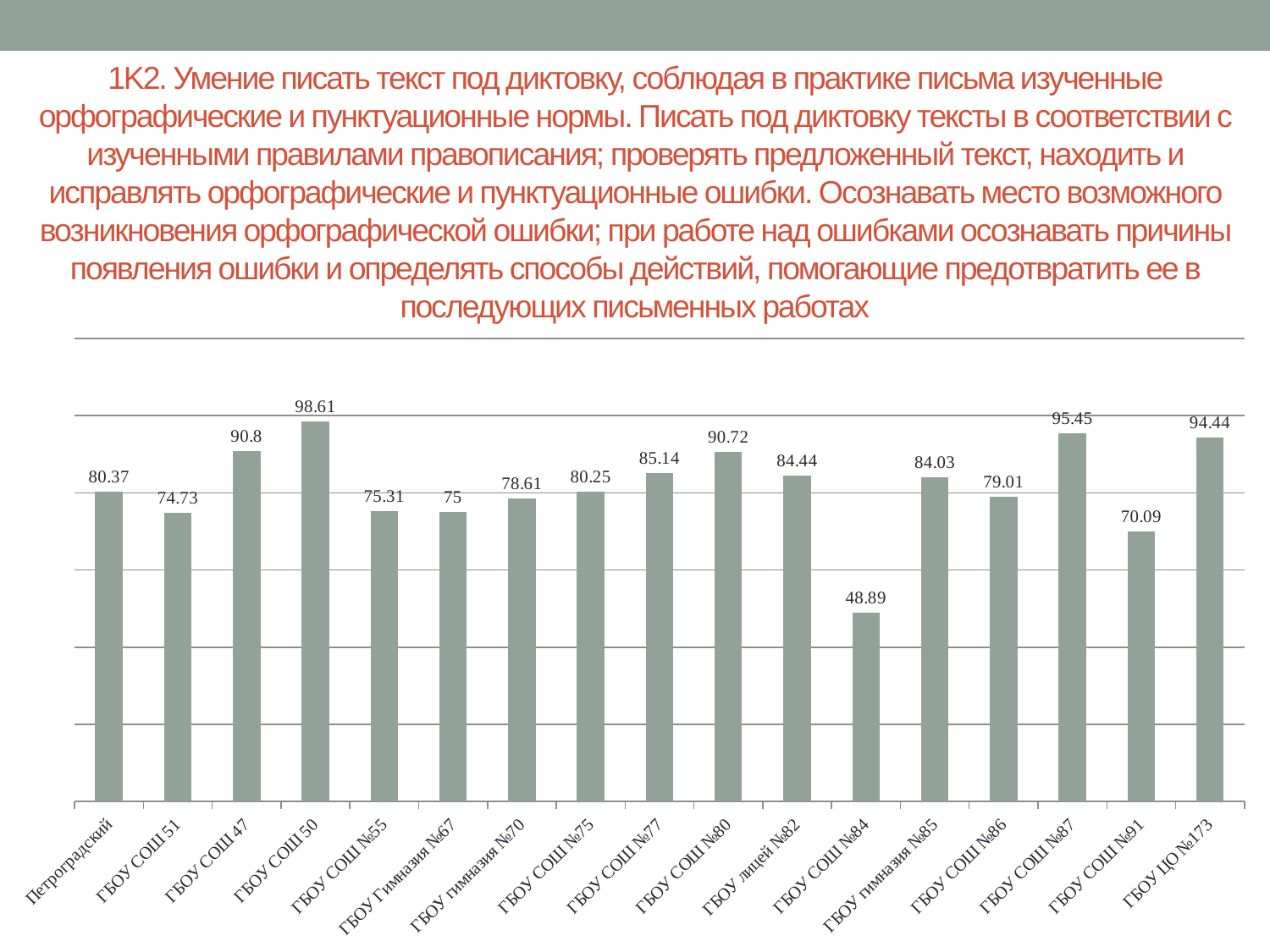
Which category has the highest value? ГБОУ СОШ 50 Which is larger, the value for ГБОУ СОШ №91 or the value for ГБОУ гимназия №70? ГБОУ гимназия №70 What is the value for Петроградский? 80.37 Which is larger, the value for ГБОУ СОШ 47 or the value for ГБОУ СОШ №80? ГБОУ СОШ 47 What is the difference between the values for ГБОУ СОШ №87 and ГБОУ СОШ №91? 25.36 What is the difference between the values for ГБОУ СОШ 50 and ГБОУ СОШ №84? 49.72 What is the value for ГБОУ СОШ 50? 98.61 What kind of chart is shown on the slide? Bar chart Which category has the lowest value? ГБОУ СОШ №84 How many categories are shown on the x axis? 17 What is the value for ГБОУ ЦО №173? 94.44 What is the value for ГБОУ СОШ №84? 48.89